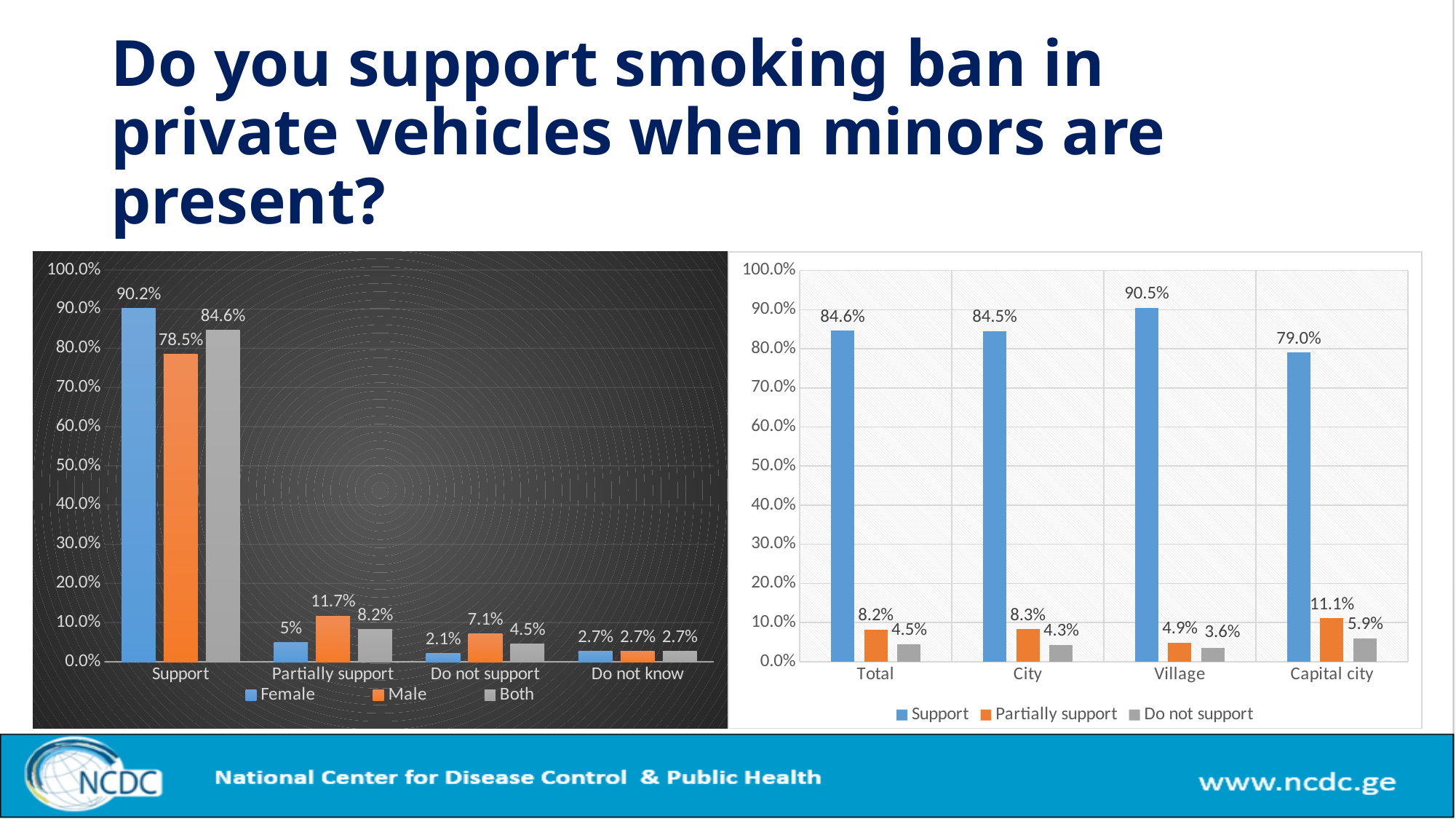
In the left chart, what is the value for Male in the Partially support category? 11.7% In the right chart, which category has the lowest Support value? Capital city In the right chart, what is the Support value for Village? 90.5% In the left chart, which series has the lowest value in the Do not support category? Female In the right chart, which is larger, the Partially support value for Capital city or for City? Capital city In the left chart, what is the value for Female in the Support category? 90.2% What kind of chart is the right chart? Bar chart In the right chart, what is the difference between the Support values for Village and Capital city? 11.5% In the left chart, what is the difference between the Female and Male values for Support? 11.7% In the left chart, how many categories are shown on the x axis? 4 In the right chart, what colour are the Do not support bars? Grey In the left chart, how many series does the legend list? 3